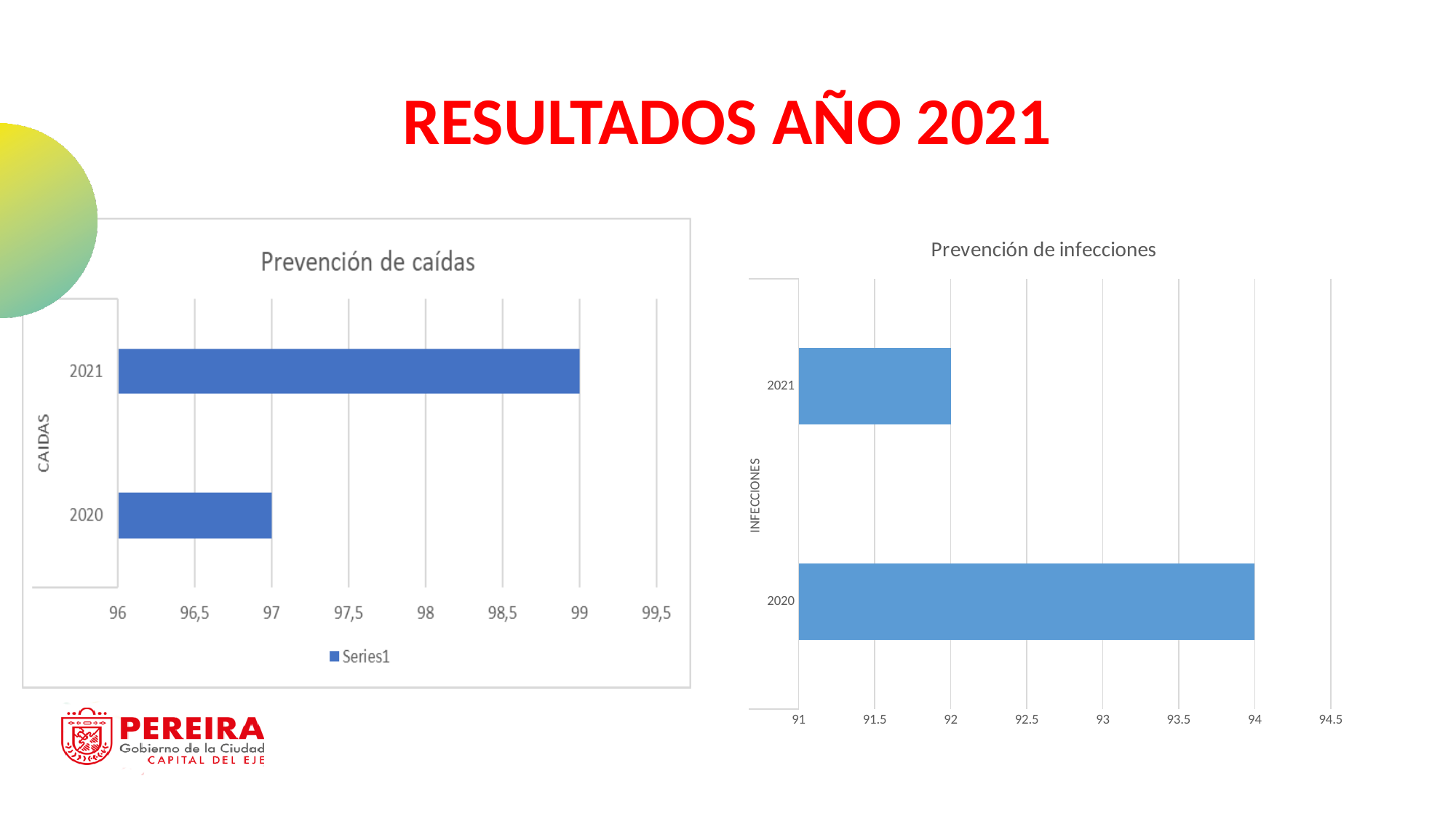
In the 'Prevención de caídas' chart, what is the difference between the values for 2021 and 2020? 2 In the 'Prevención de caídas' chart, which year has the highest value? 2021 In the 'Prevención de infecciones' chart, what is the value for 2020? 94 What is the legend entry shown in the 'Prevención de caídas' chart? Series1 In the 'Prevención de caídas' chart, what is the value for 2021? 99 What kind of chart is the 'Prevención de caídas' chart? bar chart In the 'Prevención de infecciones' chart, what is the value for 2021? 92 In the 'Prevención de caídas' chart, what is the value for 2020? 97 In the 'Prevención de infecciones' chart, is the value for 2020 greater or less than 93? greater In the 'Prevención de infecciones' chart, what is the difference between the values for 2020 and 2021? 2 How many categories are shown in the 'Prevención de infecciones' chart? 2 In the 'Prevención de infecciones' chart, which year has the lowest value? 2021